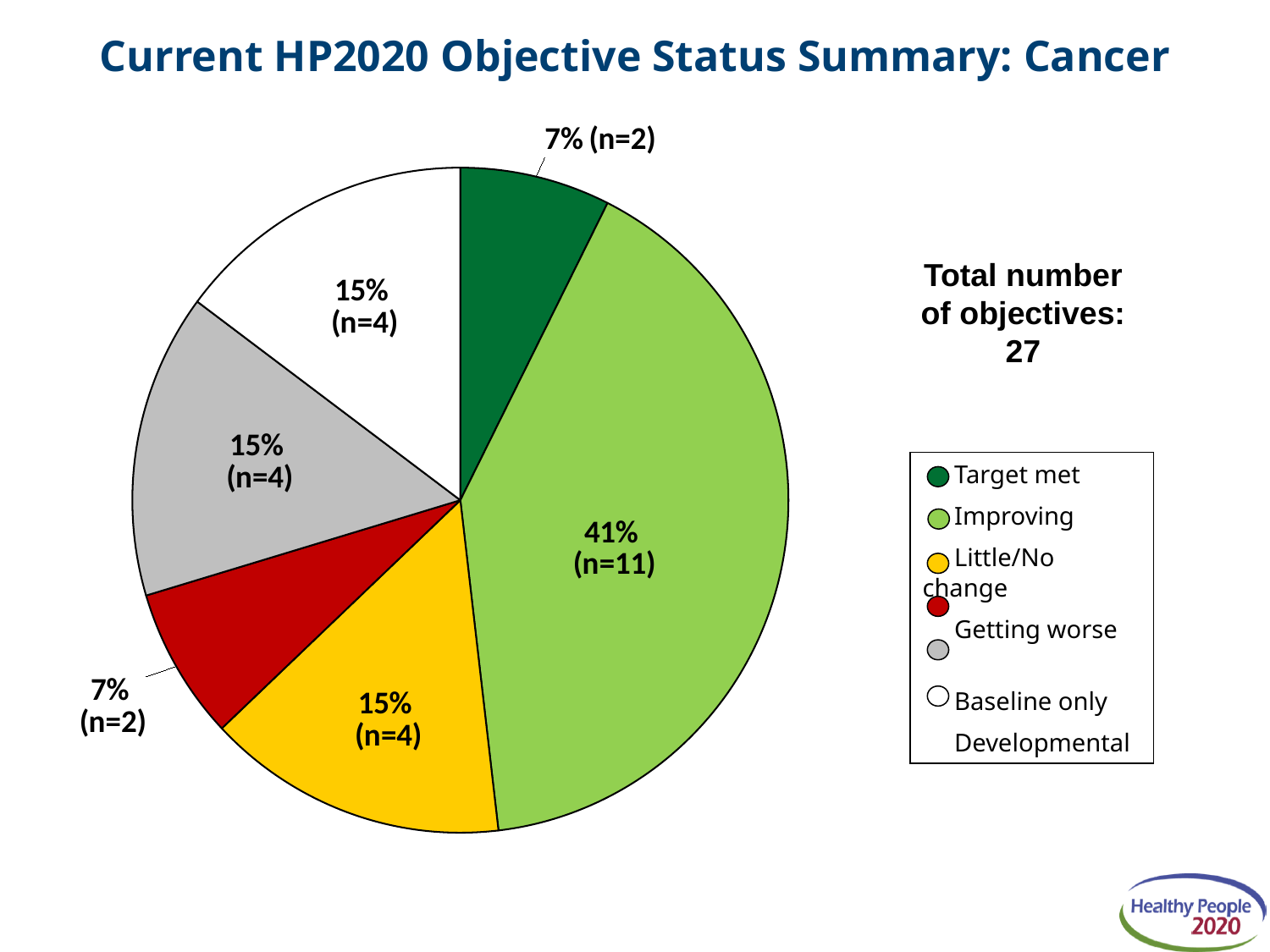
What is the title of the slide? Current HP2020 Objective Status Summary: Cancer What is the difference in percentage points between the Improving slice and the Little/No change slice? 26 percentage points Which is larger, the Target met slice or the Little/No change slice? Little/No change What kind of chart is shown on the slide? Pie chart What percentage of objectives have met their target (Target met)? 7% How many categories does the legend list? 6 Which category has the largest share of the pie? Improving How many objectives are in the Improving category? 11 How many slices does the pie chart have? 6 How many objectives are in the Little/No change category? 4 What percentage of cancer objectives are in the Improving category? 41% What is the total number of objectives stated on the slide? 27